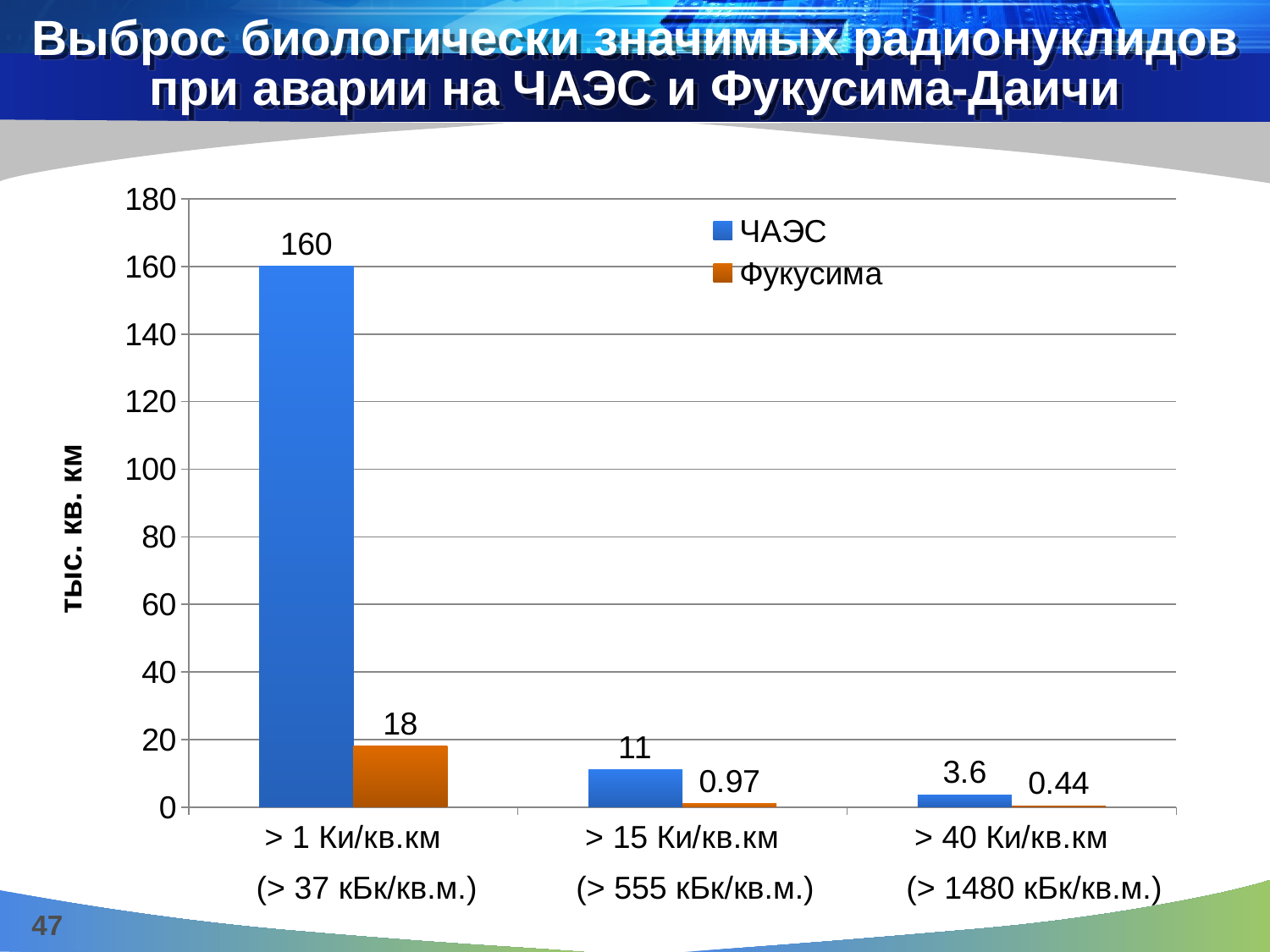
What is the value for ЧАЭС in the > 40 Ки/кв.км category? 3.6 Which category has the highest value for ЧАЭС? > 1 Ки/кв.км What is the value for Фукусима in the > 40 Ки/кв.км category? 0.44 Which category has the lowest value for Фукусима? > 40 Ки/кв.км What is the value for ЧАЭС in the > 1 Ки/кв.км category? 160 What kind of chart is shown on the slide? Bar chart How many categories are shown on the x axis? 3 What is the label of the y axis? тыс. кв. км What is the difference between the ЧАЭС and Фукусима values in the > 1 Ки/кв.км category? 142 How many series does the legend list? 2 Which is larger in the > 15 Ки/кв.км category: ЧАЭС or Фукусима? ЧАЭС What is the value for Фукусима in the > 15 Ки/кв.км category? 0.97